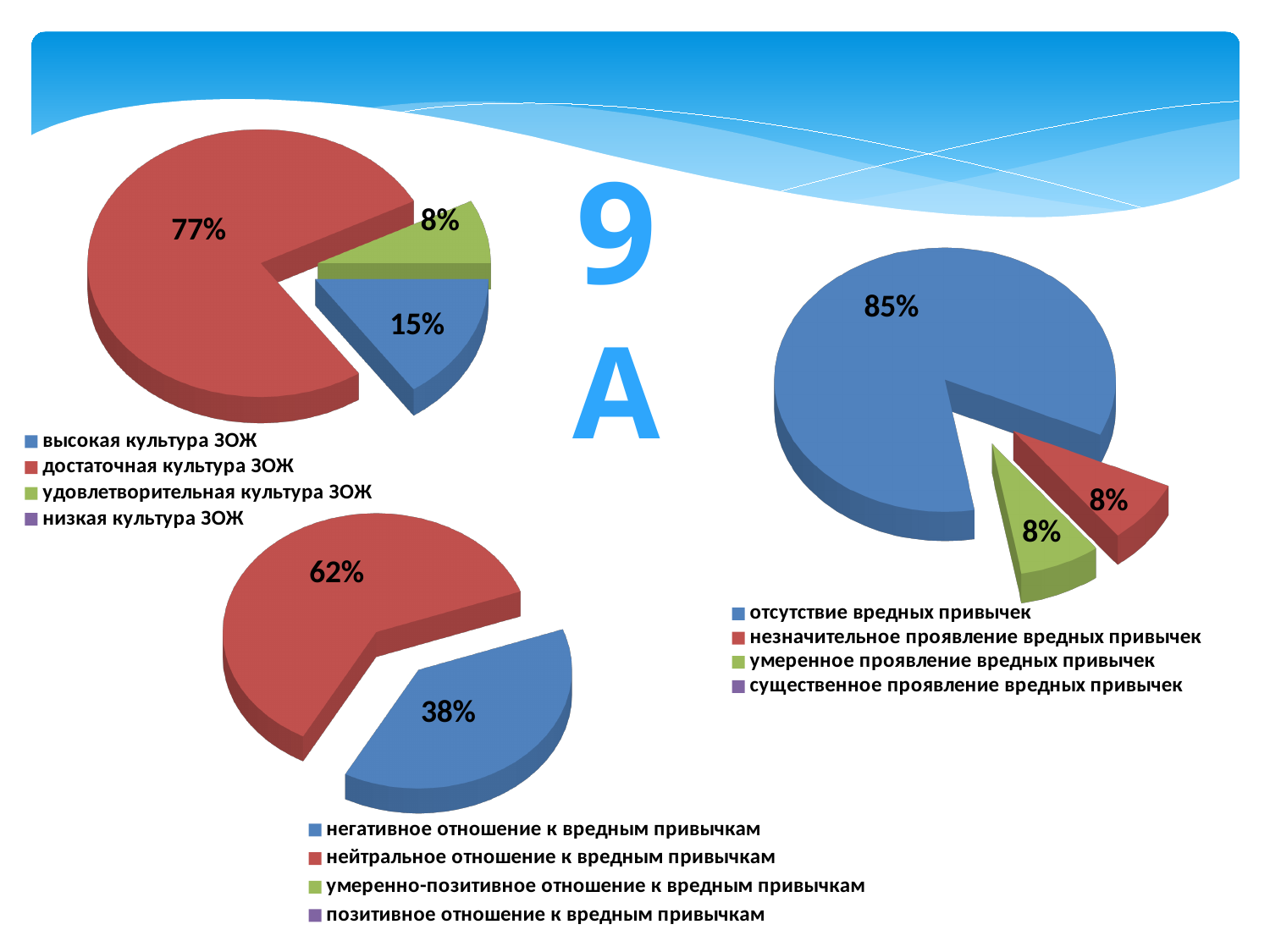
In the bottom pie chart, which is larger: the slice for 'негативное отношение к вредным привычкам' or the slice for 'нейтральное отношение к вредным привычкам'? нейтральное отношение к вредным привычкам In the top-left pie chart, what is the difference between the shares for 'достаточная культура ЗОЖ' and 'высокая культура ЗОЖ'? 62% In the top-left pie chart, what share is labelled for 'высокая культура ЗОЖ'? 15% What type of chart is the bottom chart on the slide? pie chart In the right pie chart, which category has the largest slice? отсутствие вредных привычек How many entries does the legend of the right pie chart list? 4 In the bottom pie chart, what share is labelled for 'нейтральное отношение к вредным привычкам'? 62% In the right pie chart, what share is labelled for 'отсутствие вредных привычек'? 85% In the top-left pie chart, what share is labelled for 'достаточная культура ЗОЖ'? 77% In the right pie chart, what share is labelled for 'умеренное проявление вредных привычек'? 8% In the bottom pie chart, what share is labelled for 'негативное отношение к вредным привычкам'? 38% In the top-left pie chart, which category has the largest slice? достаточная культура ЗОЖ